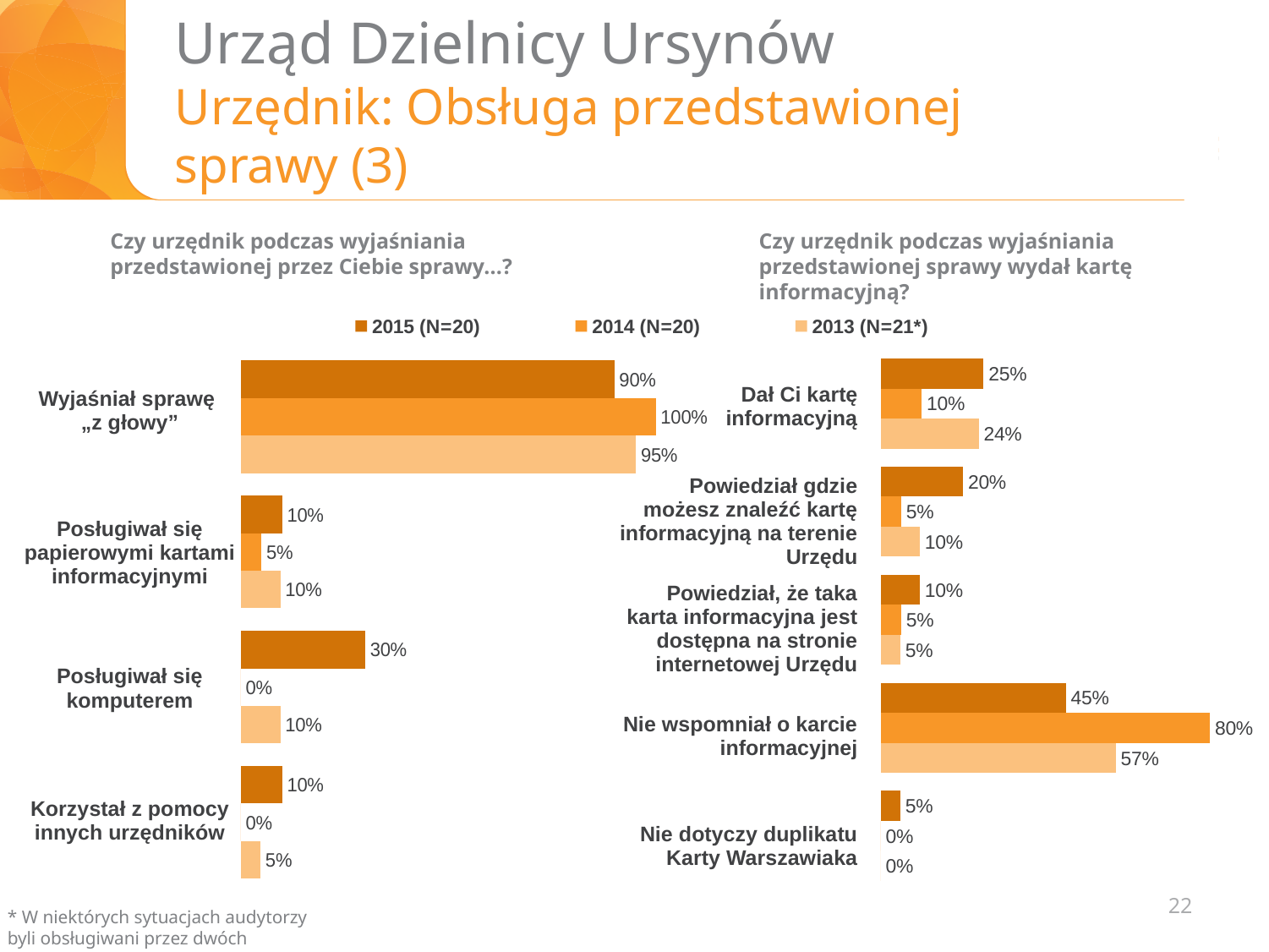
How many series does the legend list? 3 In the right chart, what is the value for "Dał Ci kartę informacyjną" in 2013 (N=21*)? 24% In the right chart, which is larger for "Nie wspomniał o karcie informacyjnej": the 2015 value or the 2013 value? 2013 How many categories does the left chart show? 4 In the left chart, which category has the highest value for 2015 (N=20)? Wyjaśniał sprawę „z głowy” In the right chart ("Czy urzędnik podczas wyjaśniania przedstawionej sprawy wydał kartę informacyjną?"), what is the value for "Nie wspomniał o karcie informacyjnej" in 2014 (N=20)? 80% In the left chart, what is the value for "Posługiwał się komputerem" in 2015 (N=20)? 30% In the left chart, what is the value for "Korzystał z pomocy innych urzędników" in 2013 (N=21*)? 5% In the right chart, which category has the lowest value for 2015 (N=20)? Nie dotyczy duplikatu Karty Warszawiaka In the left chart ("Czy urzędnik podczas wyjaśniania przedstawionej przez Ciebie sprawy...?"), what is the value for "Wyjaśniał sprawę „z głowy”" in 2014 (N=20)? 100% In the left chart, what is the difference between the 2015 and 2014 values for "Posługiwał się komputerem"? 30% In the right chart, what is the difference between the 2014 and 2015 values for "Nie wspomniał o karcie informacyjnej"? 35%